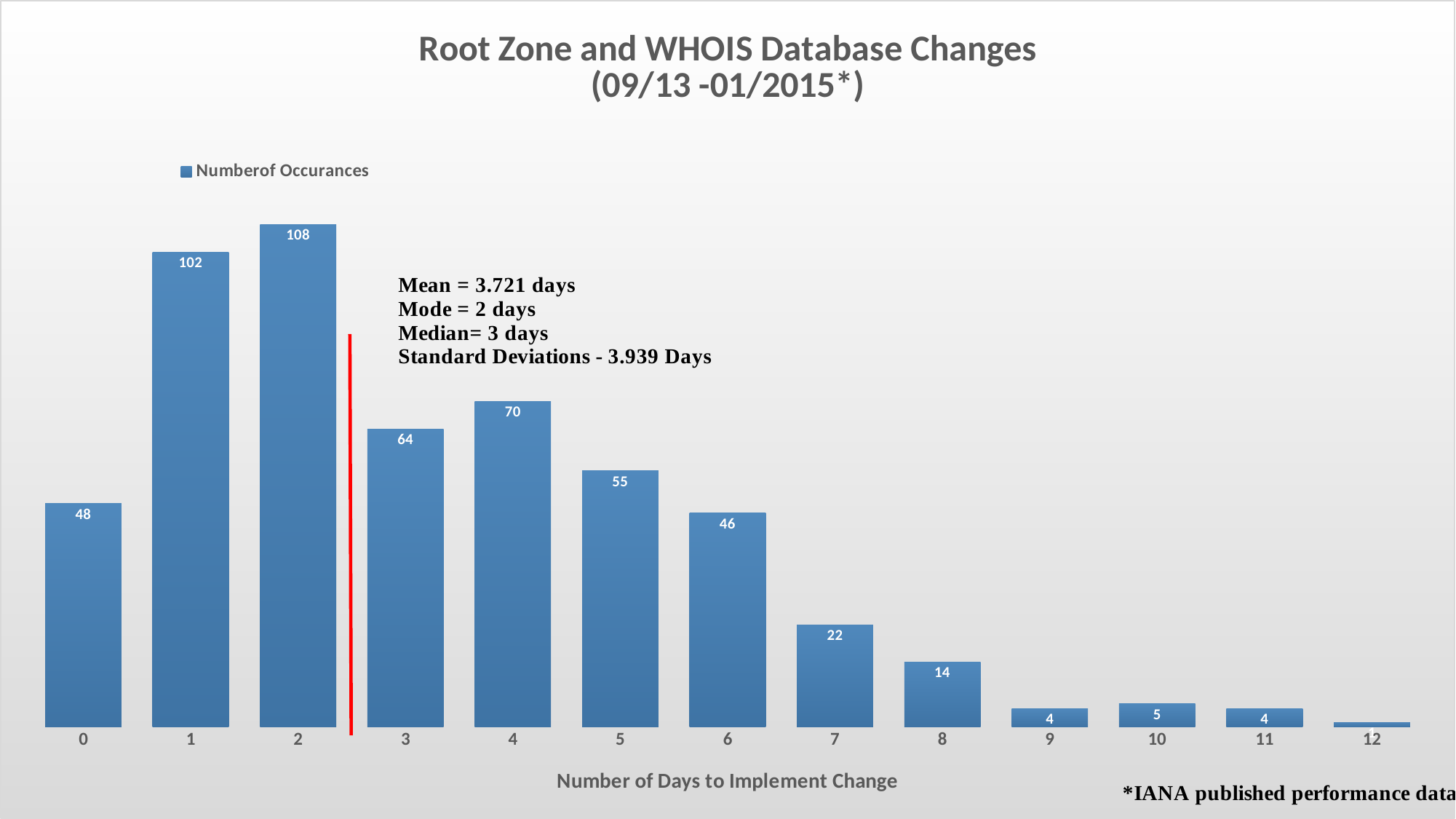
What is the number of occurrences for 2 days to implement change? 108 What is the x axis title of the chart? Number of Days to Implement Change What is the title of the chart? Root Zone and WHOIS Database Changes (09/13 -01/2015*) What kind of chart is shown on the slide? bar chart Which number of days has the highest number of occurrences? 2 What is the difference in occurrences between 1 day and 3 days? 38 How many categories are shown on the x axis? 13 Which has more occurrences, 4 days or 5 days? 4 days Do the number of occurrences rise or fall from 4 days to 9 days? fall What is the number of occurrences for 0 days to implement change? 48 How many series does the legend list? 1 What is the number of occurrences for 7 days to implement change? 22